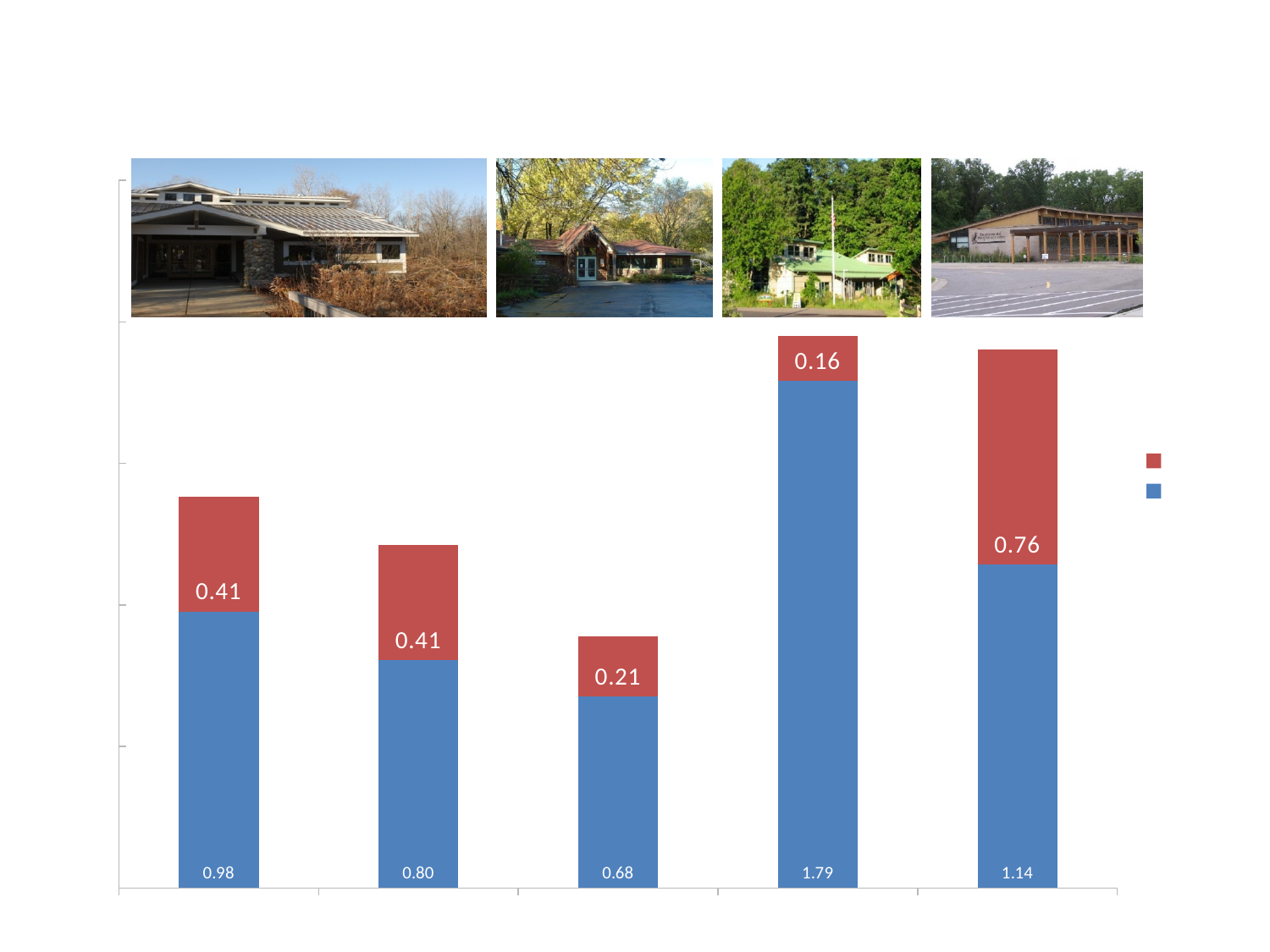
Which bar has the smallest red segment? the fourth bar (0.16) How many bars are plotted in the chart? 5 What is the difference between the blue segment of the fourth bar and the blue segment of the fifth bar? 0.65 How many series does the legend list? 2 What is the value of the blue segment of the first (leftmost) bar? 0.98 What is the value of the red segment of the fifth (rightmost) bar? 0.76 What kind of chart is shown on the slide? stacked bar chart What is the value of the red segment of the third bar? 0.21 What is the total of the first (leftmost) bar (blue plus red)? 1.39 What is the total of the fourth bar (blue plus red)? 1.95 Which is larger, the blue segment of the first bar or the blue segment of the second bar? the first bar (0.98) Which bar has the largest blue segment? the fourth bar (1.79)